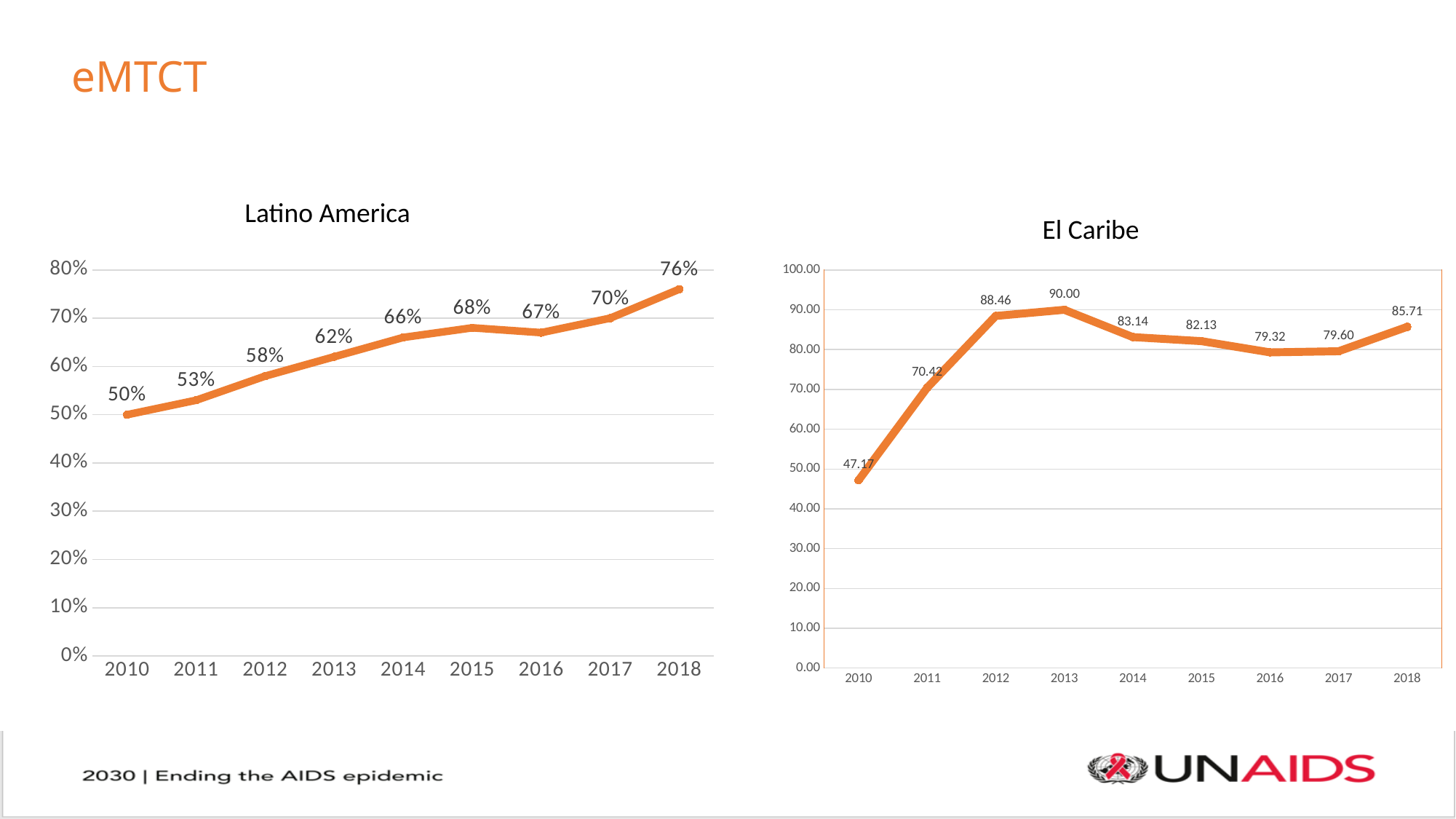
In the El Caribe chart, what is the difference between the 2013 value and the 2012 value? 1.54 What kind of chart is the El Caribe chart? Line chart What is the title of the chart on the right side of the slide? El Caribe In the El Caribe chart, what is the value for 2010? 47.17 In the Latino America chart, what is the difference between the 2018 value and the 2010 value? 26% In the Latino America chart, do the values generally rise or fall from 2010 to 2018? Rise In the Latino America chart, which year has the highest value? 2018 In the El Caribe chart, what is the value for 2013? 90.00 How many years are plotted in the Latino America chart? 9 In the El Caribe chart, which is larger, the value for 2014 or the value for 2018? 2018 In the Latino America chart, what is the value for 2014? 66% In the El Caribe chart, which year has the lowest value? 2010